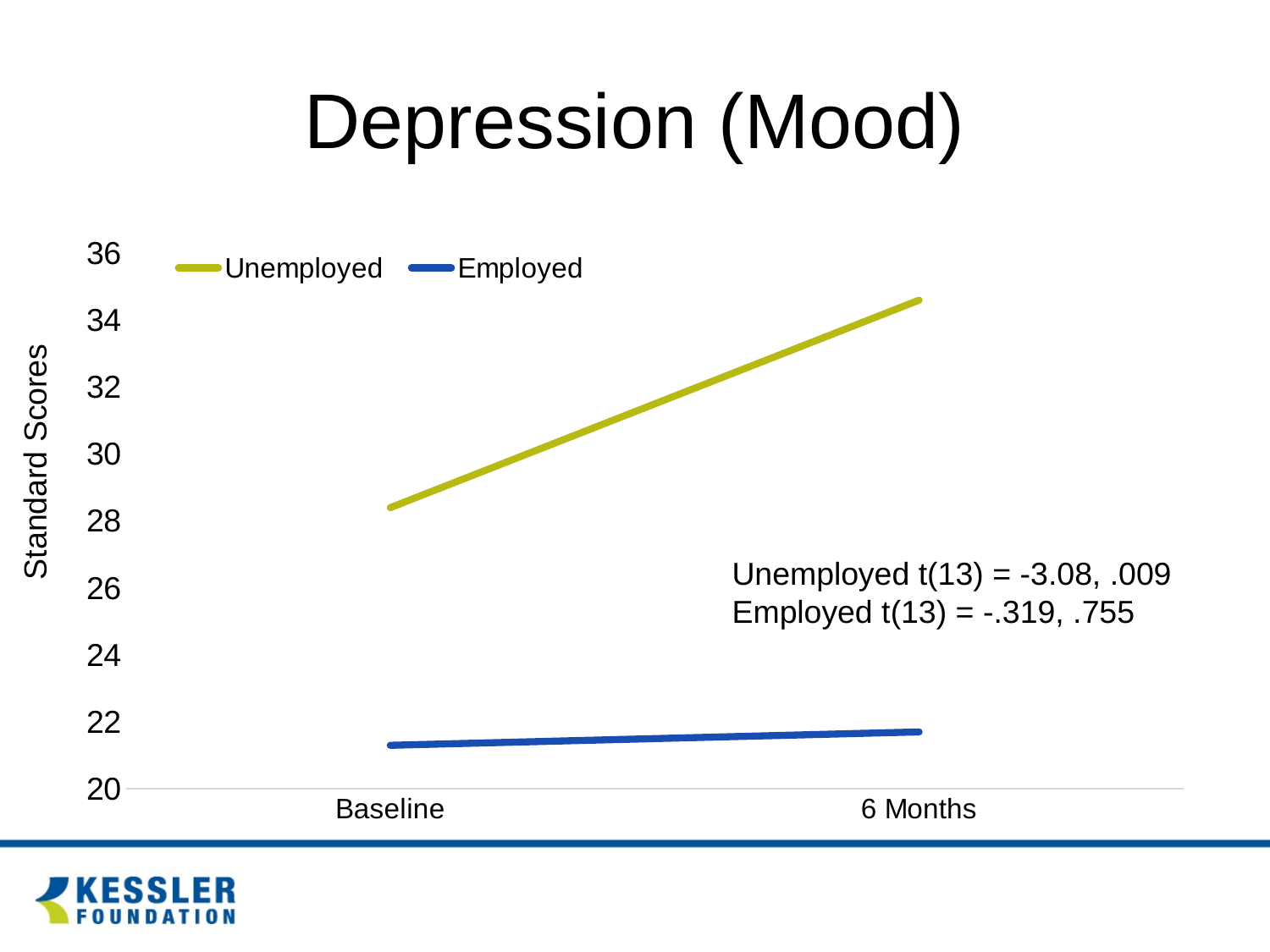
Is the Employed value at Baseline greater or less than 22? less Which series has the higher value at 6 Months, Unemployed or Employed? Unemployed Which series has the higher value at Baseline, Unemployed or Employed? Unemployed Is the Unemployed value at Baseline greater or less than 30? less How many series does the legend list? 2 What kind of chart is shown on the slide? line chart Is the Unemployed value at 6 Months greater or less than 34? greater Does the Unemployed line rise or fall from Baseline to 6 Months? rise How many time points are shown on the x axis? 2 What is the title of the chart? Depression (Mood) What is the label of the y axis? Standard Scores